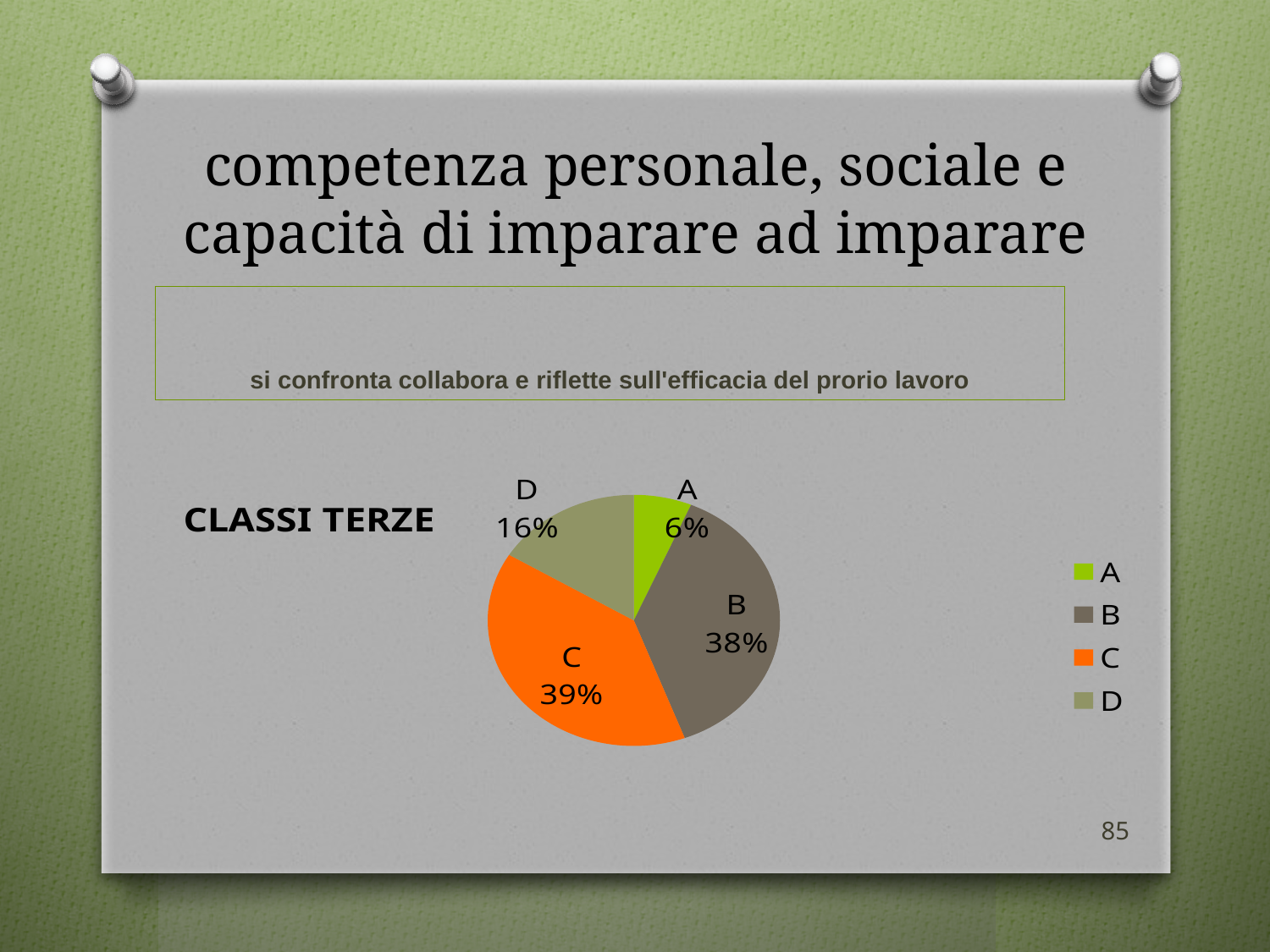
Which category has the smallest slice in the pie chart? A What colour is slice C in the pie chart? orange What kind of chart is shown on the slide? pie chart What percentage does slice D represent in the pie chart? 16% What is the difference in percentage points between slice C and slice A? 33 What is the difference in percentage points between slice B and slice D? 22 Which category has the largest slice in the pie chart? C What percentage does slice B represent in the pie chart? 38% Which is larger, slice B or slice D? B How many slices does the pie chart have? 4 How many entries does the legend list? 4 What percentage does slice A represent in the pie chart? 6%